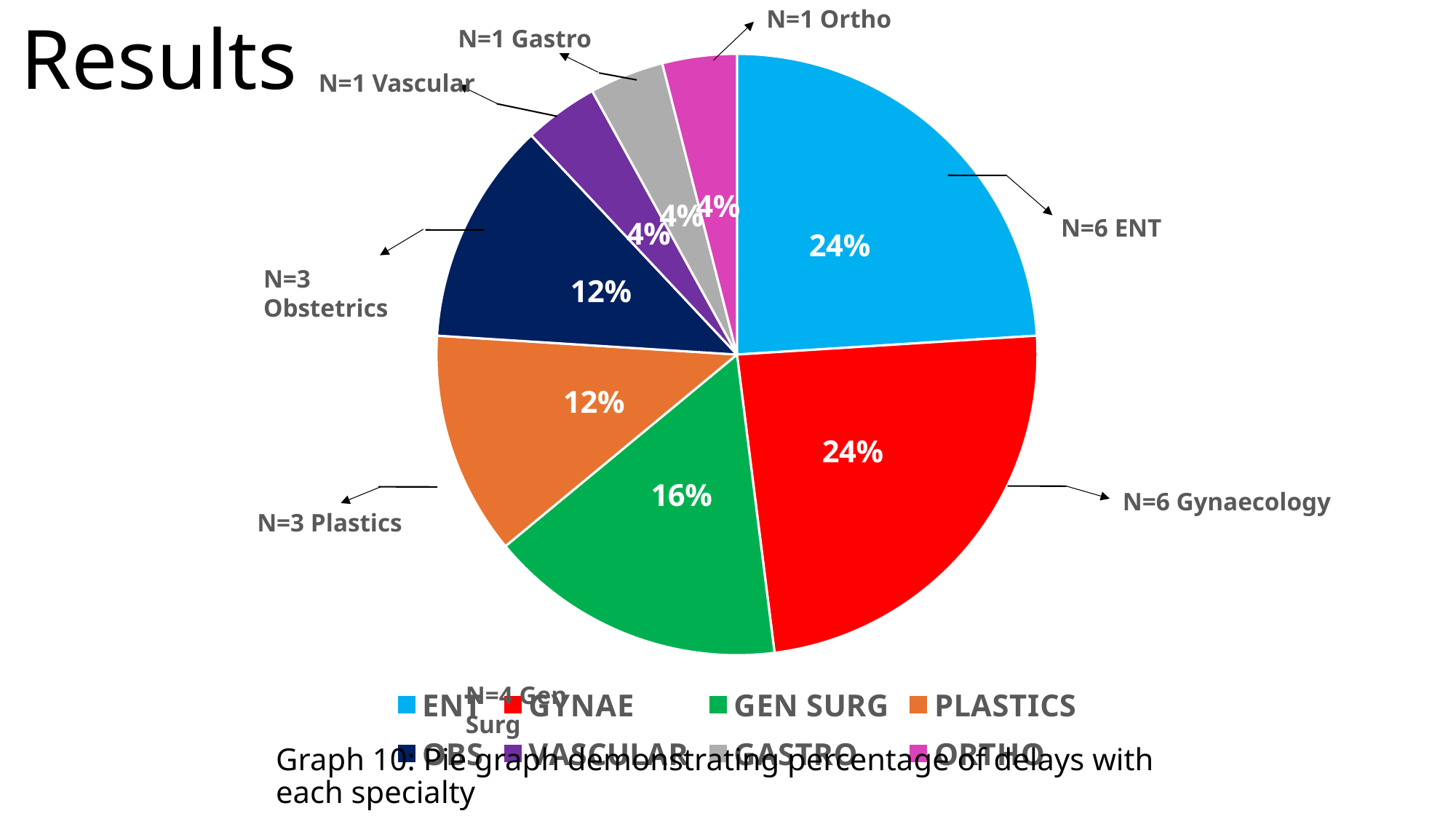
Which slice is larger, GEN SURG or PLASTICS? GEN SURG What percentage of delays is attributed to ENT? 24% How many slices does the pie chart have? 8 What percentage of delays is attributed to PLASTICS? 12% How many cases (N) does the annotation give for Gynaecology? N=6 What is the difference in percentage points between the ENT slice and the GEN SURG slice? 8% What colour is the GYNAE slice in the pie chart? red How many entries does the legend list? 8 What percentage of delays is attributed to VASCULAR? 4% Which slice is larger, OBS or GASTRO? OBS What type of chart is shown on the slide? pie chart What percentage of delays is attributed to GEN SURG? 16%